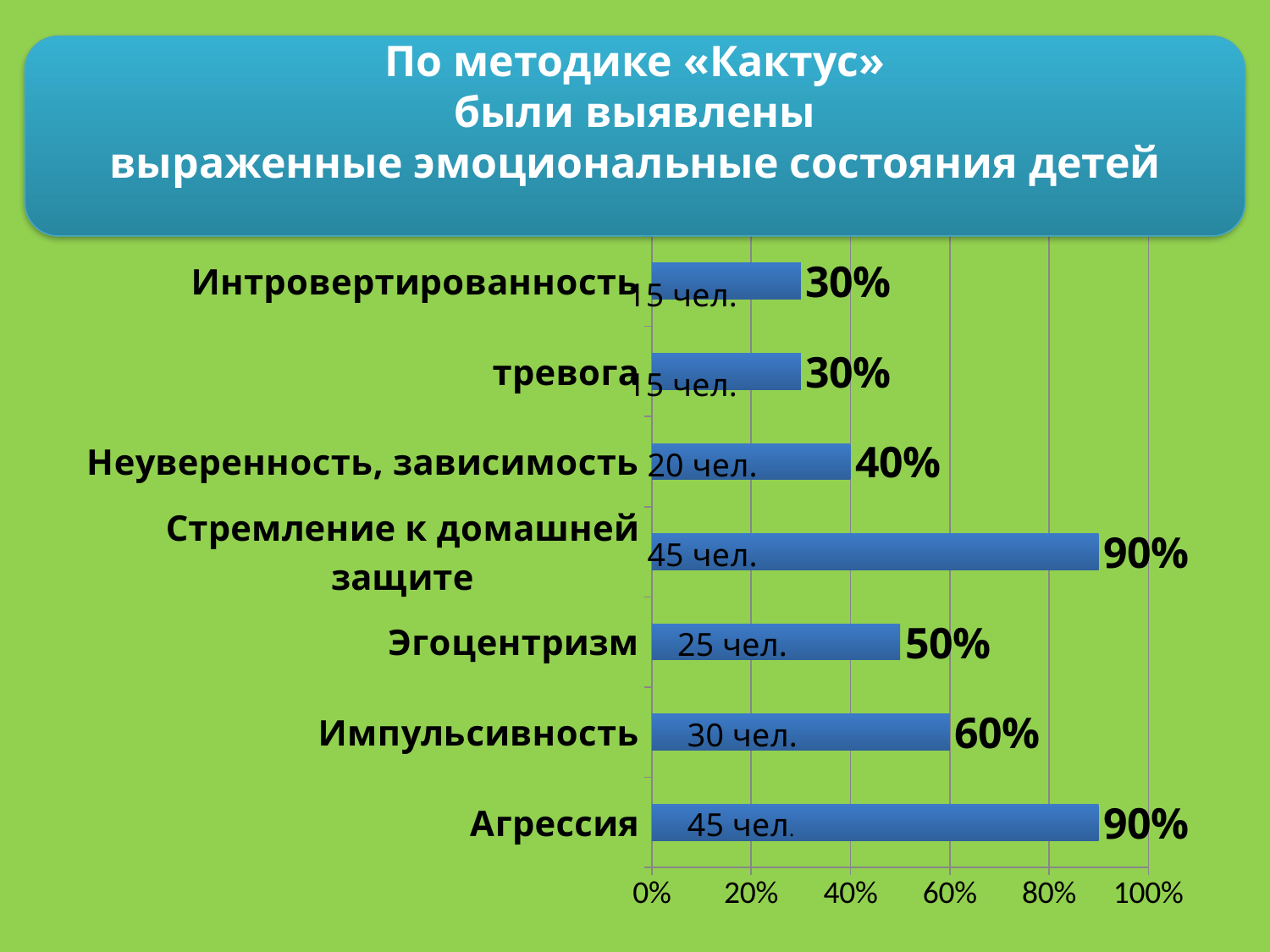
How many children (чел.) are indicated for Стремление к домашней защите? 45 чел. Is the value for Интровертированность greater or less than 40%? less What kind of chart is shown on the slide? bar chart What is the maximum value shown on the horizontal axis? 100% What percentage is shown for Эгоцентризм? 50% What percentage is shown for Импульсивность? 60% What is the difference in percentage between Агрессия and Импульсивность? 30% How many categories are plotted in the chart? 7 Which is larger, the value for Эгоцентризм or the value for Неуверенность, зависимость? Эгоцентризм What percentage is shown for Неуверенность, зависимость? 40% How many children (чел.) are indicated for тревога? 15 чел. What percentage is shown for Агрессия? 90%